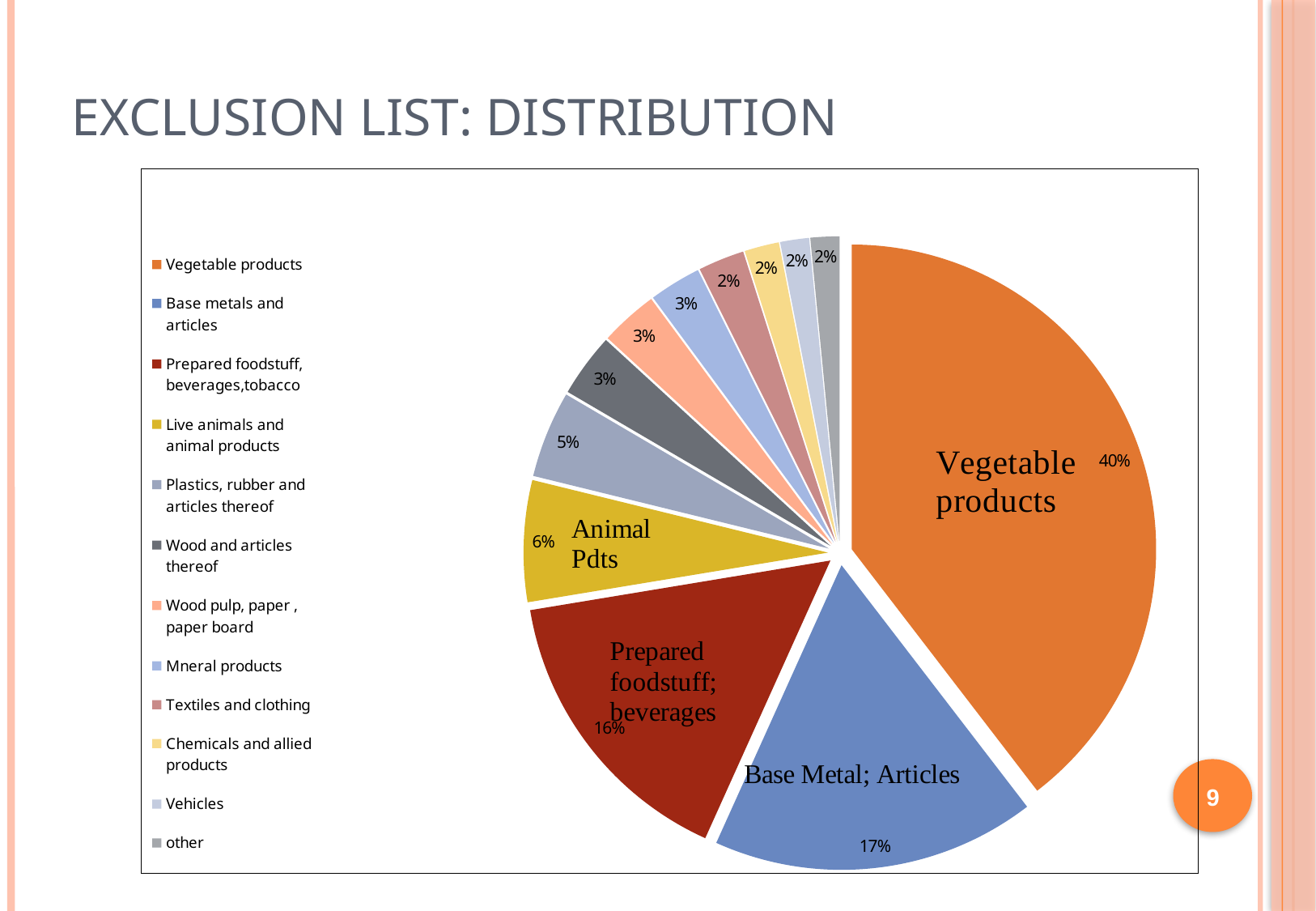
What share of the pie is Prepared foodstuff, beverages, tobacco? 16% Which is larger, the slice for Base metals and articles or the slice for Live animals and animal products? Base metals and articles What share of the pie is Vegetable products? 40% What share of the pie is Live animals and animal products? 6% What share of the pie is Base metals and articles? 17% Which category has the largest slice of the pie? Vegetable products What is the difference in percentage points between Vegetable products and Base metals and articles? 23 What is the title of the slide containing the chart? EXCLUSION LIST: DISTRIBUTION What kind of chart is shown on the slide? pie chart What is the combined share of Vegetable products and Prepared foodstuff, beverages, tobacco? 56% How many categories does the legend list? 12 What share of the pie is Plastics, rubber and articles thereof? 5%